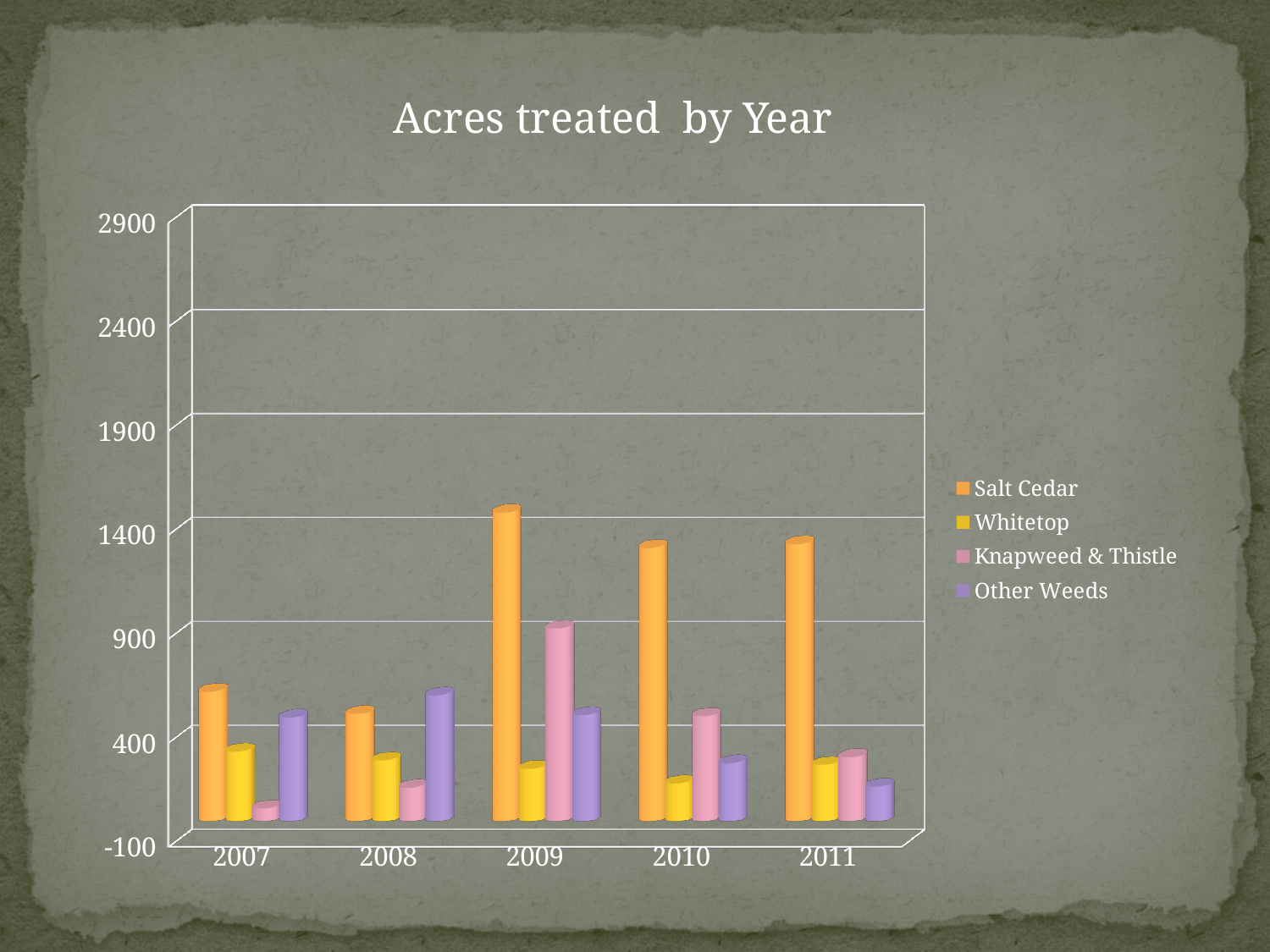
What is the title of the chart? Acres treated by Year In which year is the Knapweed & Thistle value lowest? 2007 How many series does the legend list? 4 What kind of chart is shown on the slide? Bar chart In 2009, which is larger: the Salt Cedar value or the Knapweed & Thistle value? Salt Cedar Is the Salt Cedar value for 2007 greater or less than 900? less In which year is the Salt Cedar value lowest? 2008 Which series is shown in orange in the legend? Salt Cedar In which year is the Salt Cedar value highest? 2009 In which year is the Knapweed & Thistle value highest? 2009 How many years are shown on the x axis of the chart? 5 Is the Salt Cedar value for 2009 greater or less than 1400? greater